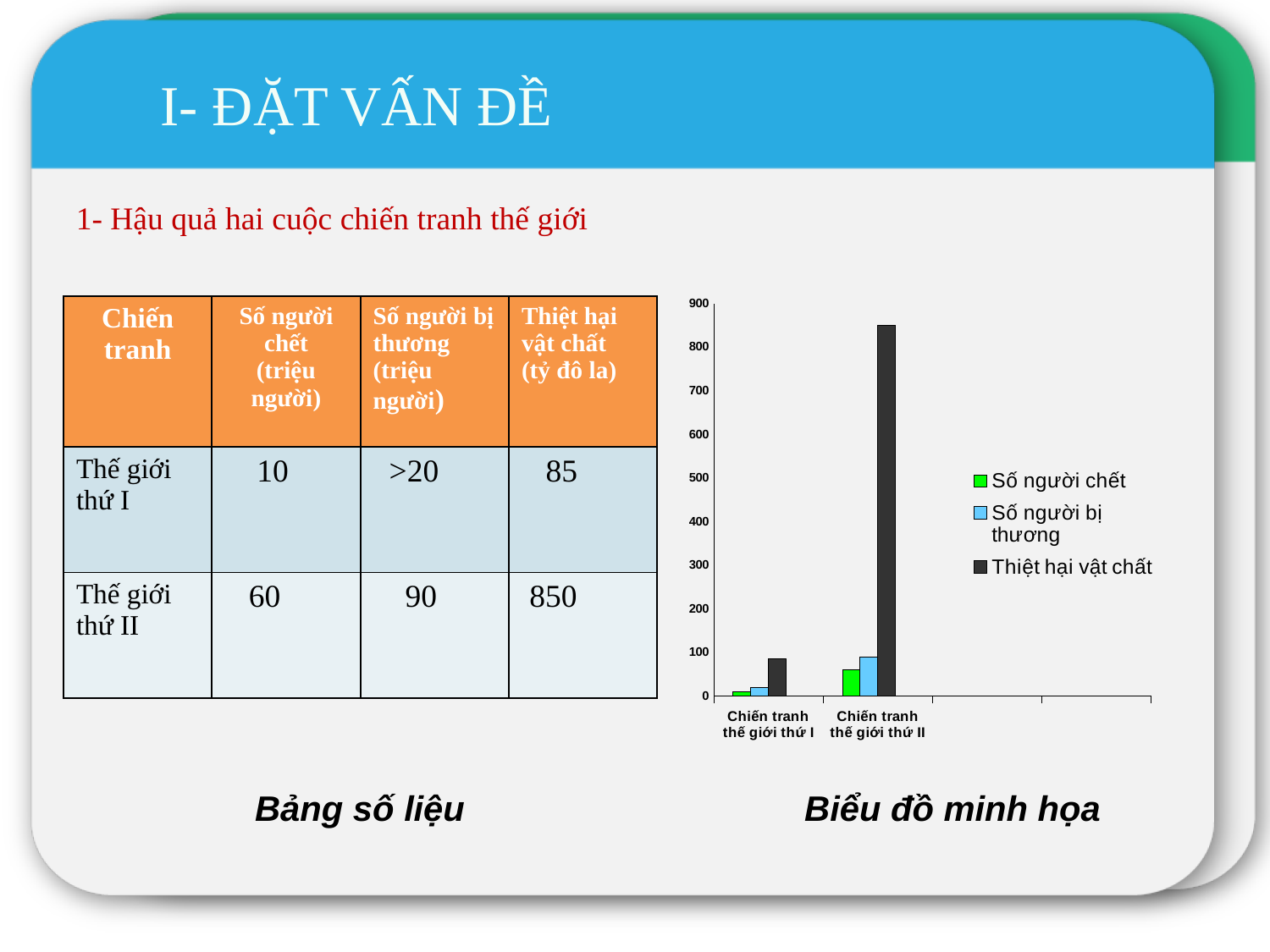
According to the slide, what is the Thiệt hại vật chất value (tỷ đô la) for Thế giới thứ II? 850 What is the difference in Thiệt hại vật chất (tỷ đô la) between Thế giới thứ II and Thế giới thứ I? 765 In the chart, which category has the larger Số người chết bar, Chiến tranh thế giới thứ I or Chiến tranh thế giới thứ II? Chiến tranh thế giới thứ II Which category has the tallest Thiệt hại vật chất bar in the chart? Chiến tranh thế giới thứ II What caption appears below the chart? Biểu đồ minh họa How many categories are shown on the x axis of the chart? 2 Do the values of all three series rise or fall from Chiến tranh thế giới thứ I to Chiến tranh thế giới thứ II? rise How many series does the chart's legend list? 3 What kind of chart is shown on the right of the slide? bar chart In the chart, is the Thiệt hại vật chất value for Chiến tranh thế giới thứ I greater or less than 100? less According to the slide, what is the Số người chết value (triệu người) for Thế giới thứ I? 10 In the chart, is the Thiệt hại vật chất value for Chiến tranh thế giới thứ II greater or less than 800? greater